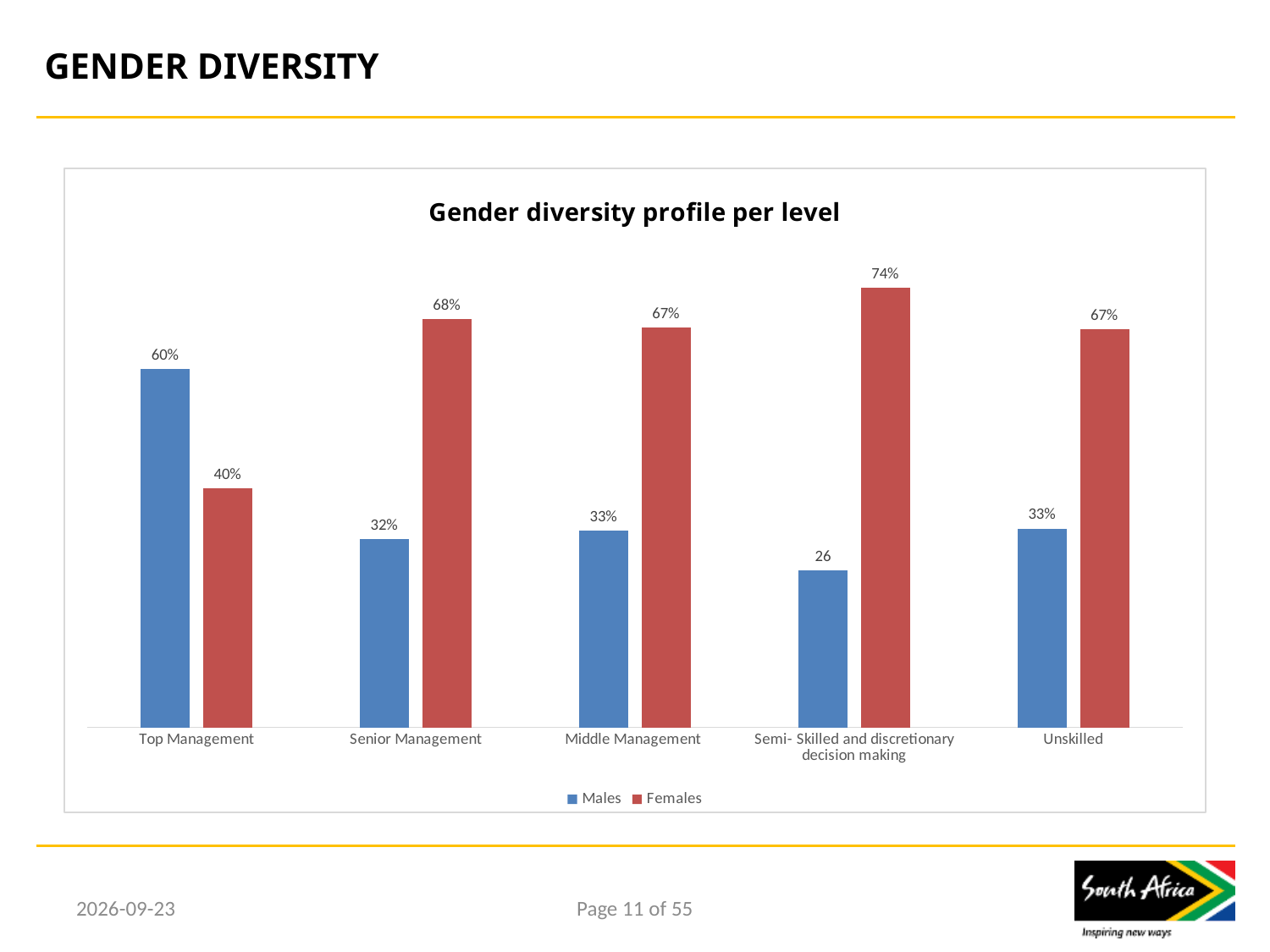
How many levels are shown on the x axis? 5 Which level has the lowest Females value? Top Management Which level has the highest Males value? Top Management What is the value for Males at Semi- Skilled and discretionary decision making? 26 At Top Management, which is larger, the Males value or the Females value? Males What is the value for Males at Top Management? 60% What is the value for Females at Senior Management? 68% What type of chart is shown? Bar chart What is the difference between the Females and Males values at Middle Management? 34% What is the value for Females at Unskilled? 67% Which level has the highest Females value? Semi- Skilled and discretionary decision making How many series does the legend list? 2